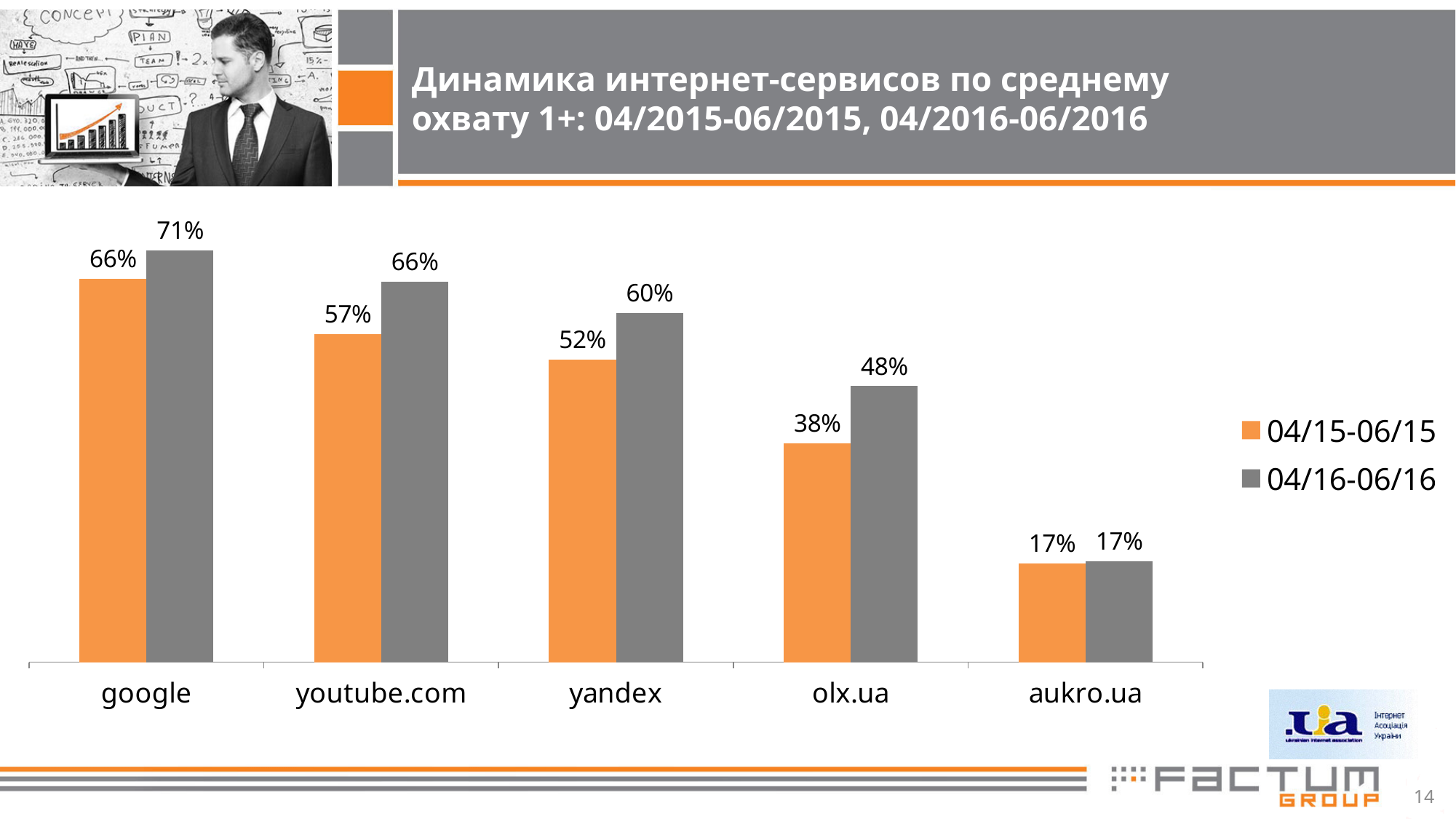
How many categories are shown on the x axis? 5 What is the difference between the 04/16-06/16 and 04/15-06/15 values for olx.ua? 10% What is the value for google in the 04/16-06/16 series? 71% What kind of chart is shown on the slide? bar chart Which is larger: the 04/15-06/15 value for youtube.com or the 04/15-06/15 value for yandex? youtube.com Which category has the highest value in the 04/15-06/15 series? google Which category has the lowest value in the 04/16-06/16 series? aukro.ua Which colour represents the 04/15-06/15 series in the legend? orange What is the value for yandex in the 04/16-06/16 series? 60% How many series does the legend list? 2 What is the value for olx.ua in the 04/15-06/15 series? 38% What is the difference between the 04/16-06/16 and 04/15-06/15 values for youtube.com? 9%